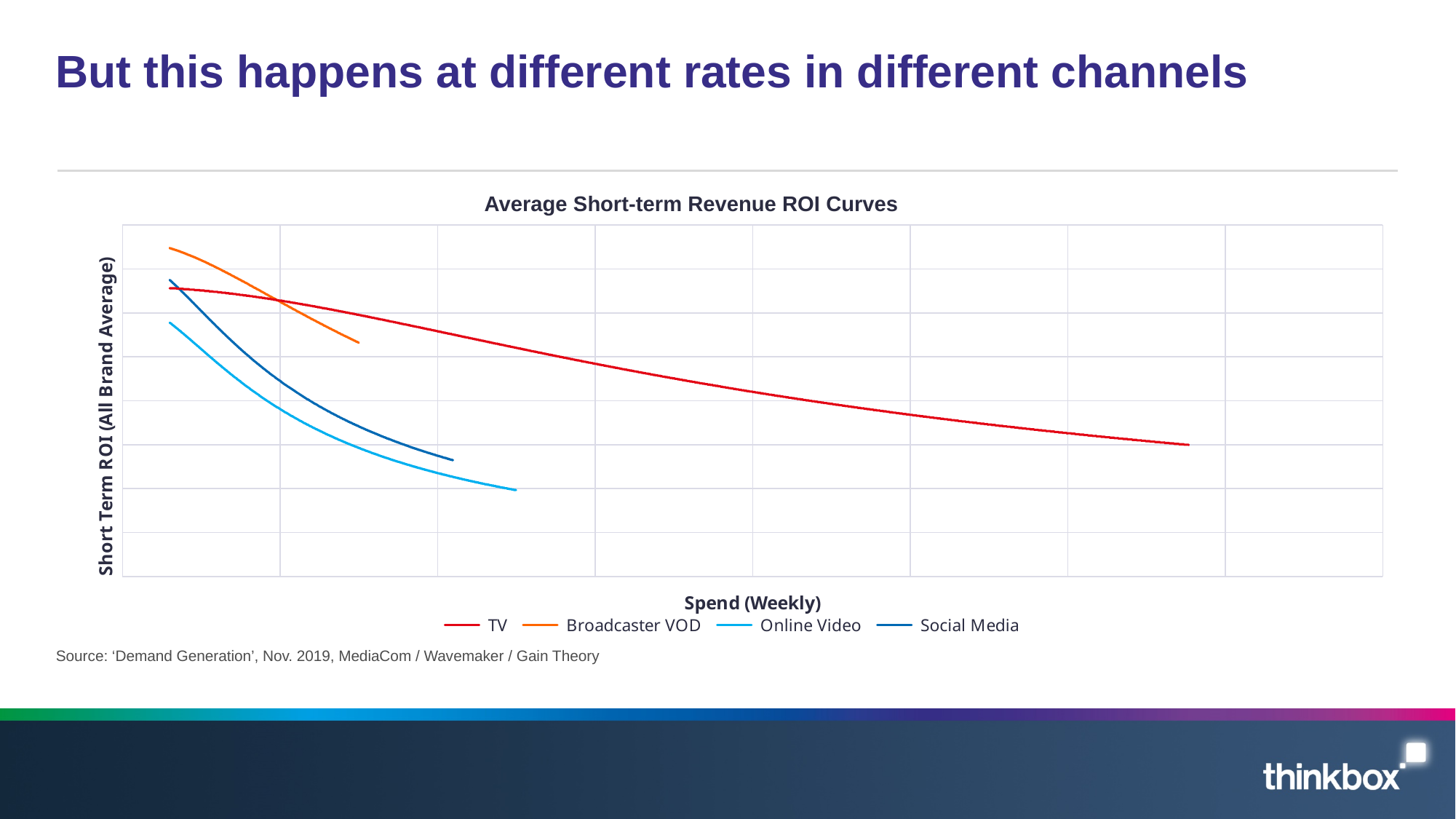
How many series does the legend list? 4 Which series starts at the highest ROI at the lowest spend level? Broadcaster VOD What is the label on the x axis of the chart? Spend (Weekly) What is the title of the chart? Average Short-term Revenue ROI Curves Which series extends furthest along the spend axis? TV Do the ROI curves rise or fall as weekly spend increases? Fall Which series ends at the lowest ROI at the end of its curve? Online Video At the end of their curves, which has the higher ROI: TV or Social Media? TV What kind of chart is shown on the slide? Line chart Which series starts at the lowest ROI at the lowest spend level? Online Video Which series declines most gradually as spend increases? TV Which series has the shortest curve along the spend axis? Broadcaster VOD